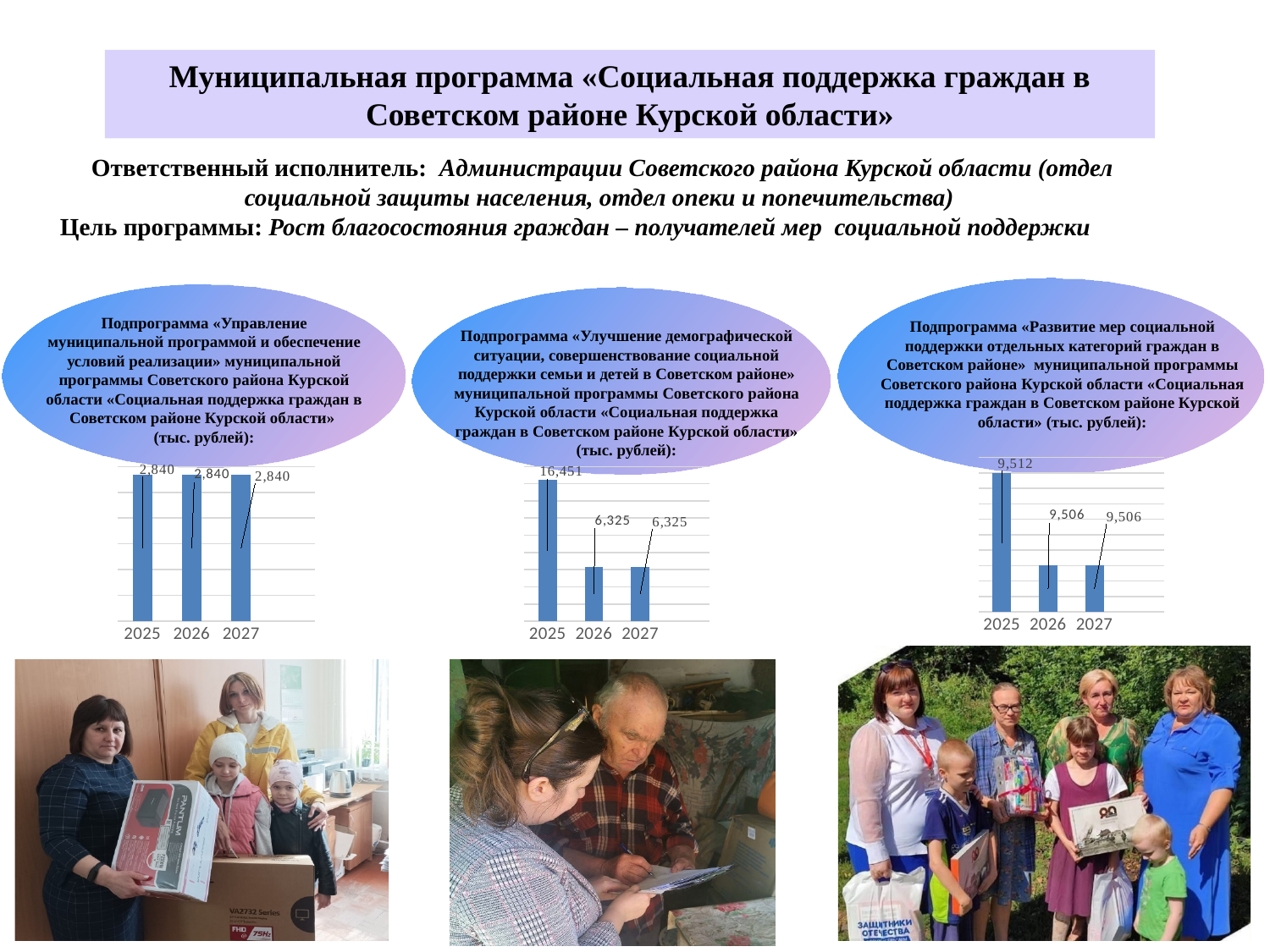
In the middle chart, what is the value for 2027? 6,325 In the middle chart, do the values rise or fall from 2025 to 2026? fall In the middle chart, which is larger, the value for 2025 or the value for 2027? 2025 In the middle chart, what is the value for 2025? 16,451 What kind of chart is the middle chart? bar chart In the right chart, what is the difference between the values for 2025 and 2027? 6 In the middle chart, which year has the highest value? 2025 In the middle chart, what is the difference between the values for 2025 and 2026? 10,126 In the left chart, what is the value for 2025? 2,840 How many years are shown on the x axis of the left chart? 3 In the right chart, which year has the highest value? 2025 In the right chart, what is the value for 2026? 9,506